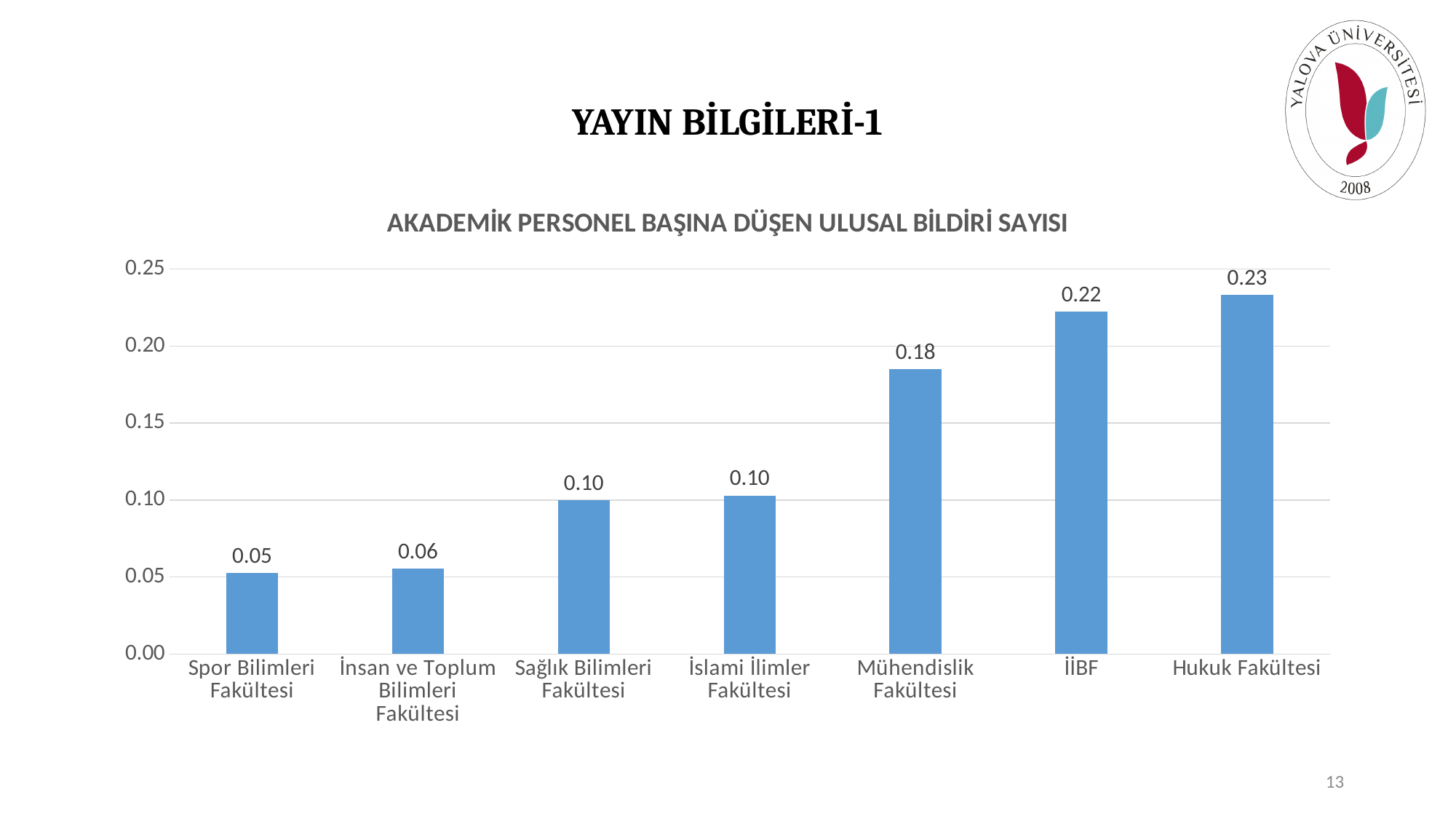
Which faculty has the lowest value? Spor Bilimleri Fakültesi What is the title of the chart? AKADEMİK PERSONEL BAŞINA DÜŞEN ULUSAL BİLDİRİ SAYISI What is the value for Mühendislik Fakültesi? 0.18 How many faculties are shown on the chart? 7 Which is larger, the value for Mühendislik Fakültesi or the value for Sağlık Bilimleri Fakültesi? Mühendislik Fakültesi What is the difference between the values for Hukuk Fakültesi and Spor Bilimleri Fakültesi? 0.18 What is the value for Spor Bilimleri Fakültesi? 0.05 What is the value for Hukuk Fakültesi? 0.23 What is the difference between the values for İİBF and Mühendislik Fakültesi? 0.04 Which faculty has the highest value? Hukuk Fakültesi What is the value for İİBF? 0.22 What kind of chart is shown on the slide? Bar chart